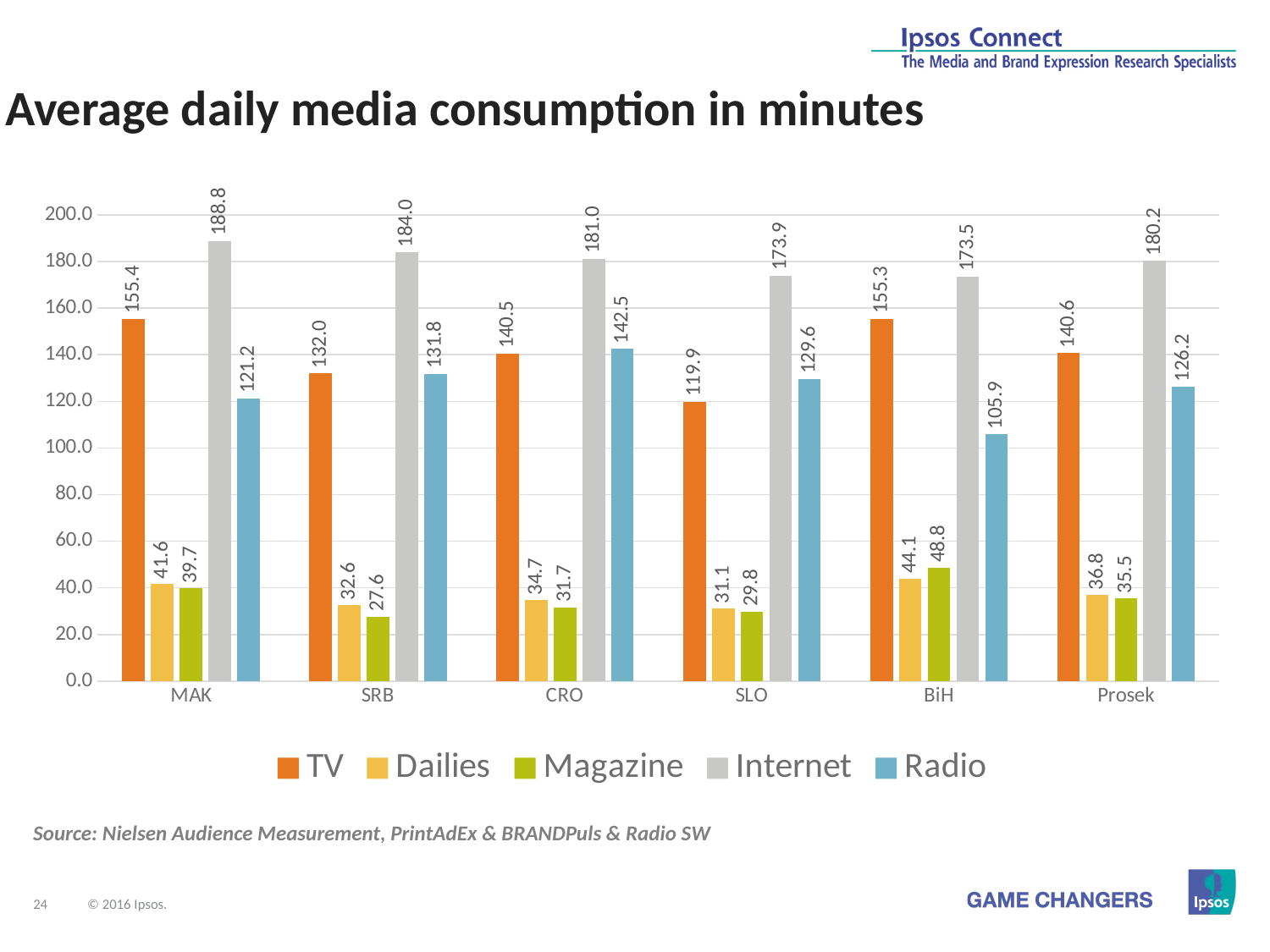
How many series does the legend list? 5 For CRO, which is larger: the Radio value or the TV value? Radio Which category has the lowest TV value? SLO Is the Radio value for SLO greater or less than 120? greater Which category has the highest Magazine value? BiH How many categories are shown on the x axis? 6 What is the difference between the Internet and TV values for SRB? 52.0 What is the Dailies value for Prosek? 36.8 What is the Radio value for BiH? 105.9 Which category has the highest Internet value? MAK What kind of chart is shown on the slide? bar chart What is the Internet value for MAK? 188.8